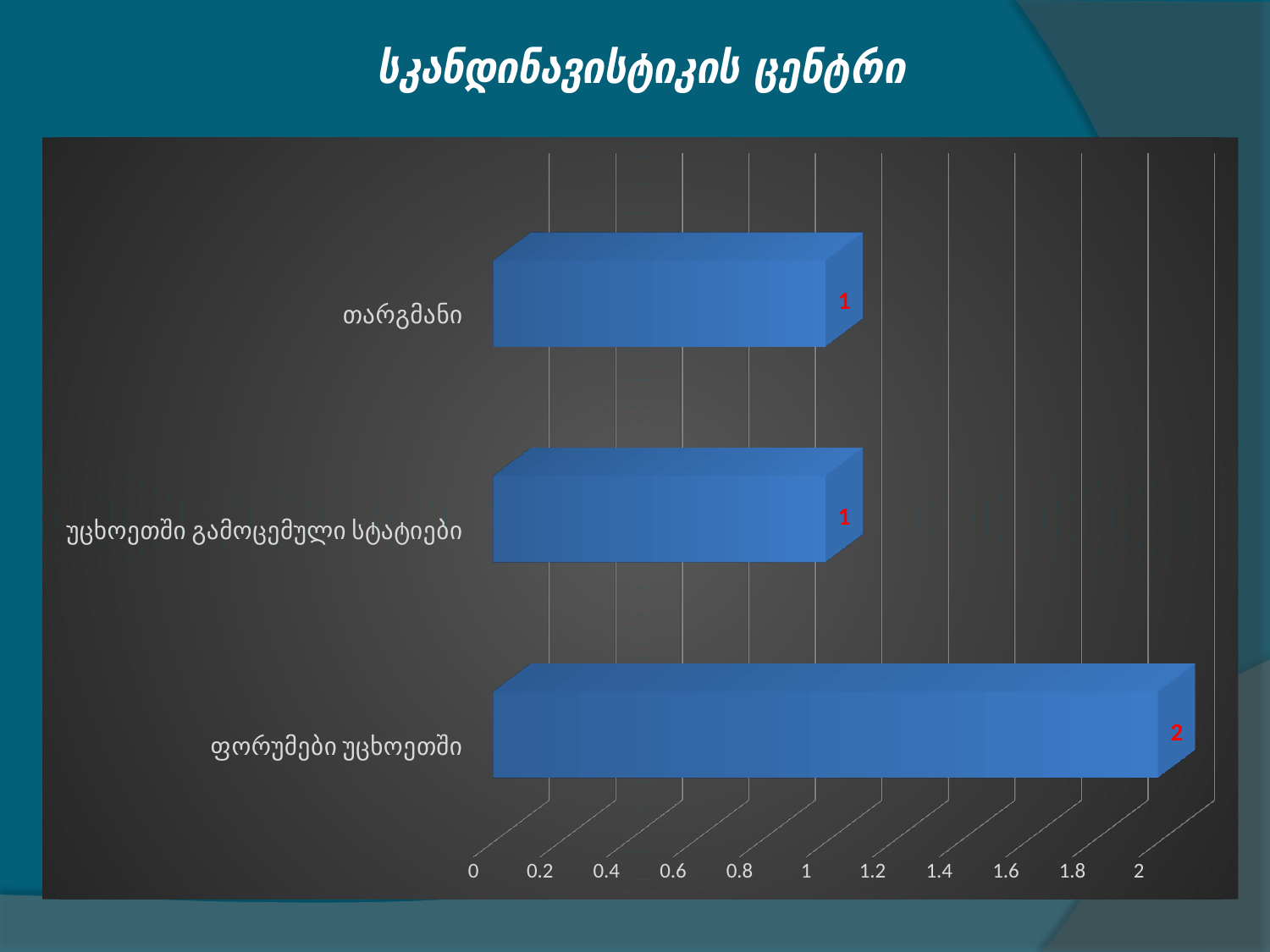
Which is larger, the value for ფორუმები უცხოეთში or the value for უცხოეთში გამოცემული სტატიები? ფორუმები უცხოეთში What is the value for ფორუმები უცხოეთში? 2 What is the difference between the values for ფორუმები უცხოეთში and თარგმანი? 1 Which category has the highest value? ფორუმები უცხოეთში What is the value for თარგმანი? 1 Is the value for თარგმანი greater or less than 1.4? less What kind of chart is shown on the slide? bar chart How many categories are shown in the chart? 3 What is the maximum value shown on the value axis? 2 What is the title of the slide? სკანდინავისტიკის ცენტრი Is the value for ფორუმები უცხოეთში greater or less than 1.6? greater What is the value for უცხოეთში გამოცემული სტატიები? 1